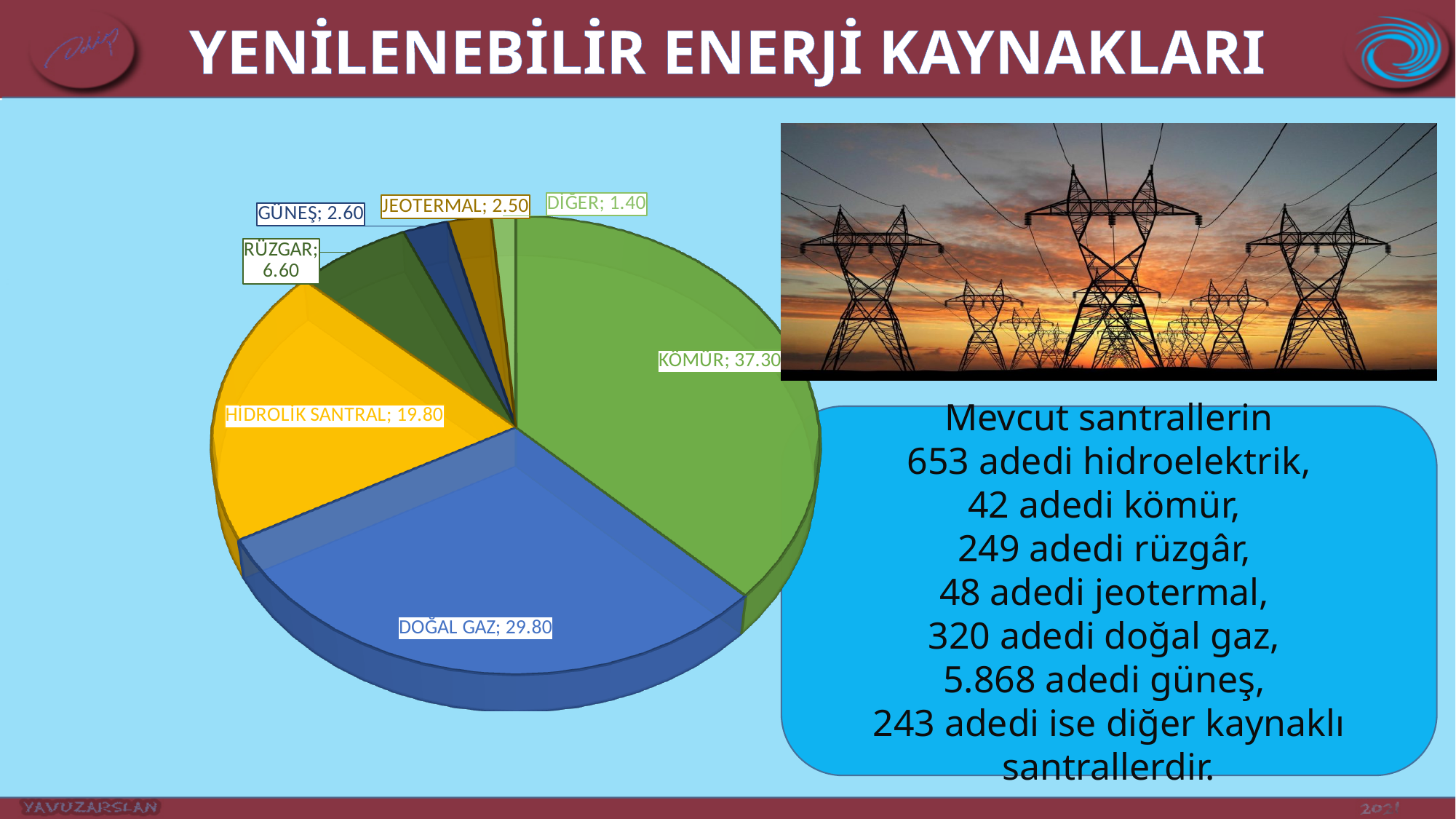
What kind of chart is shown on the slide? pie chart What is the value shown for KÖMÜR in the pie chart? 37.30 What share of the pie does DOĞAL GAZ represent? 29.80 What is the value shown for HİDROLİK SANTRAL in the pie chart? 19.80 Which category has the largest slice in the pie chart? KÖMÜR What is the value shown for DOĞAL GAZ in the pie chart? 29.80 What is the difference between the values for KÖMÜR and DOĞAL GAZ? 7.50 Which is larger, the value for HİDROLİK SANTRAL or the value for RÜZGAR? HİDROLİK SANTRAL What is the value shown for JEOTERMAL in the pie chart? 2.50 How many slices does the pie chart have? 7 What is the value shown for RÜZGAR in the pie chart? 6.60 Which category has the smallest slice in the pie chart? DİĞER